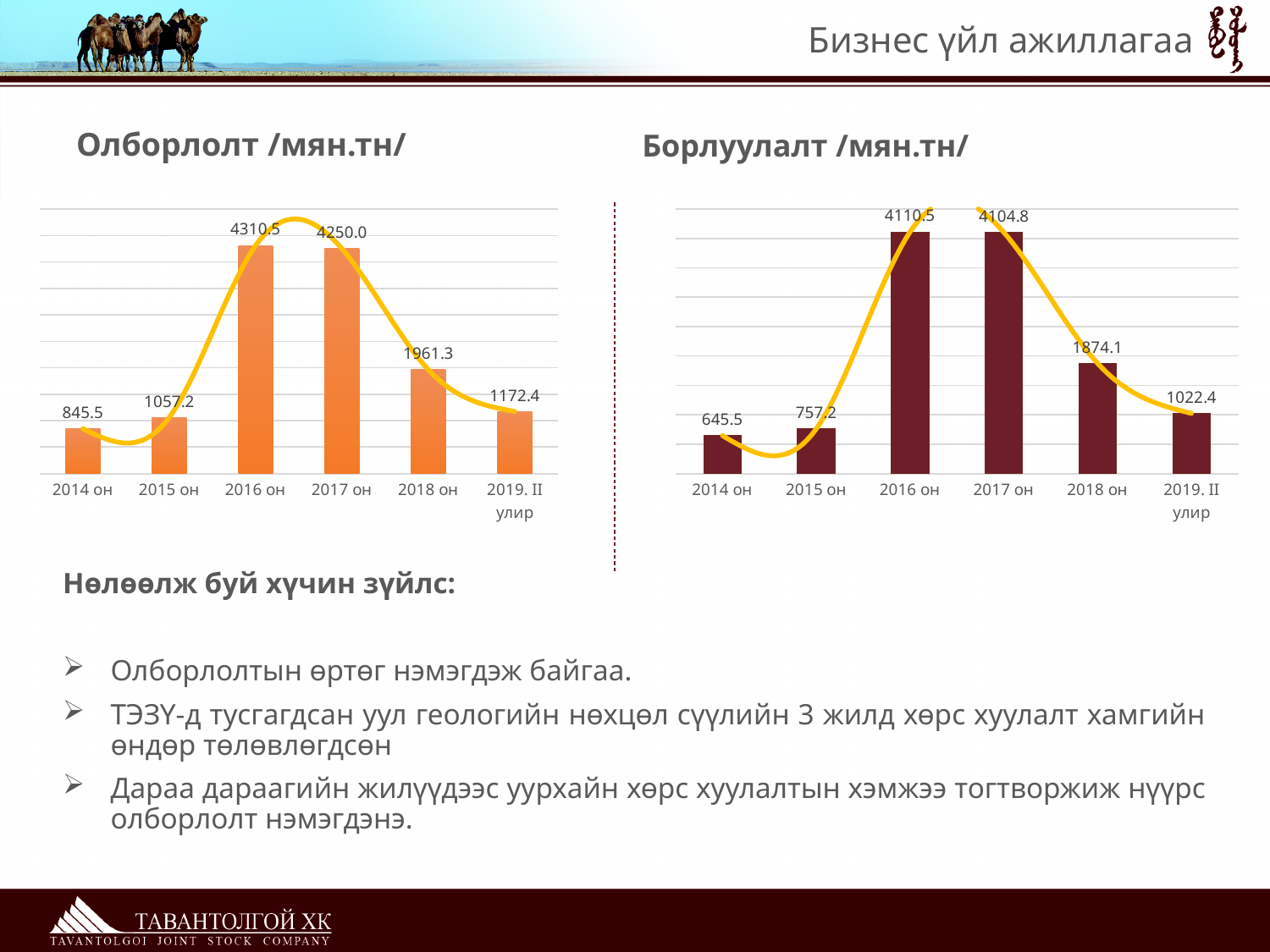
In the Борлуулалт /мян.тн/ chart, which category has the lowest value? 2014 он In the Борлуулалт /мян.тн/ chart, what is the value for 2014 он? 645.5 In the Олборлолт /мян.тн/ chart, what is the difference between the values for 2017 он and 2018 он? 2288.7 In the Борлуулалт /мян.тн/ chart, what is the difference between the values for 2015 он and 2014 он? 111.7 In the Борлуулалт /мян.тн/ chart, what is the value for 2018 он? 1874.1 In the Олборлолт /мян.тн/ chart, which year has the highest value? 2016 он In the Олборлолт /мян.тн/ chart, what is the value for 2016 он? 4310.5 How many categories are shown on the x axis of the Олборлолт /мян.тн/ chart? 6 What kind of chart is the Борлуулалт /мян.тн/ chart? Bar chart In the Олборлолт /мян.тн/ chart, what is the value for 2019. II улир? 1172.4 In the Олборлолт /мян.тн/ chart, do the values rise or fall from 2017 он to 2019. II улир? Fall In the Борлуулалт /мян.тн/ chart, which is larger, the value for 2018 он or the value for 2019. II улир? 2018 он